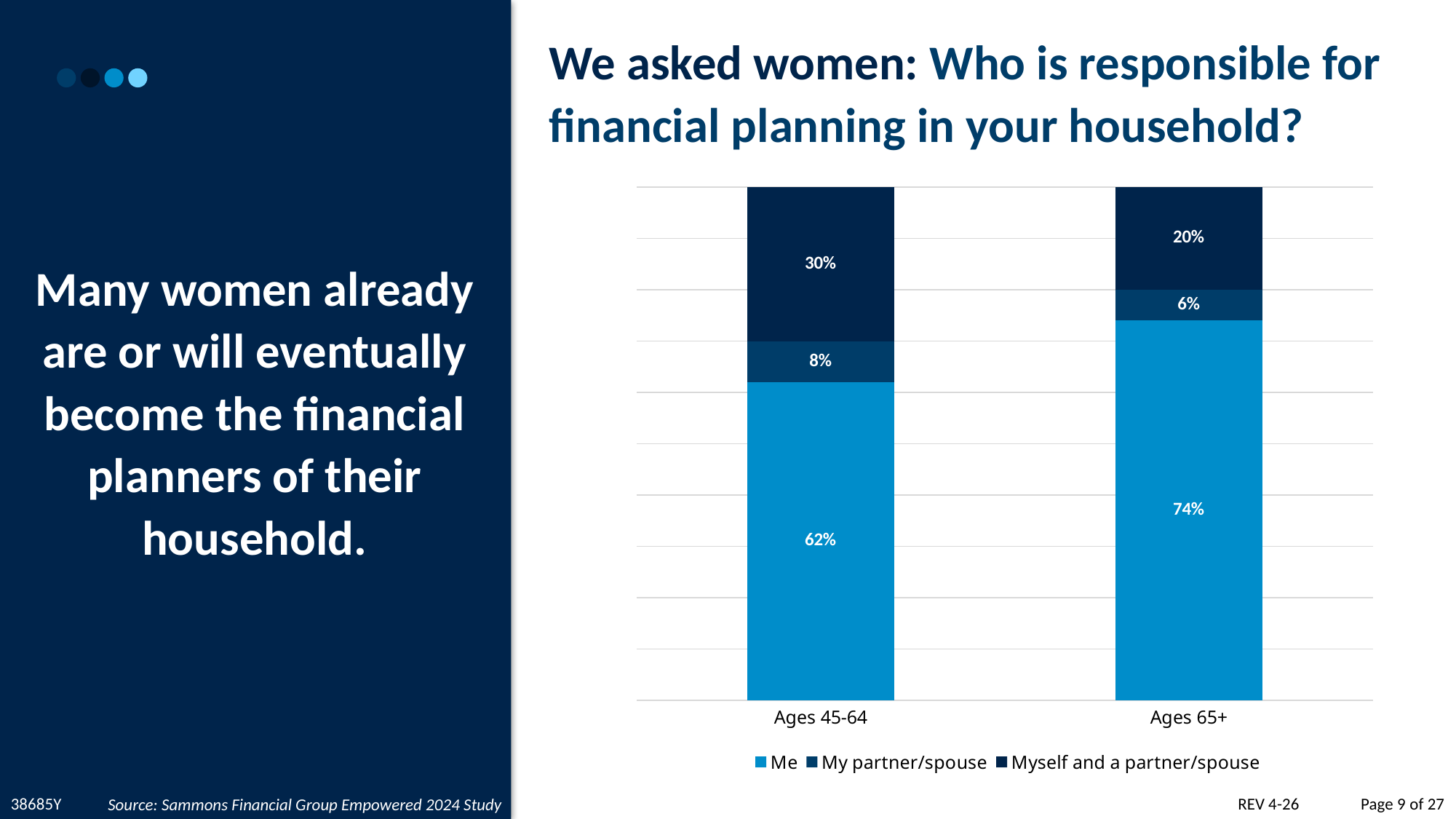
What is the total of the stacked bar for Ages 45-64? 100% What is the difference between the "Me" shares for Ages 65+ and Ages 45-64? 12% What percentage of women aged 45-64 said "My partner/spouse" is responsible? 8% Which age group has the higher share answering "Me"? Ages 65+ How many series does the legend list? 3 What percentage of women aged 65+ said "My partner/spouse" is responsible? 6% What percentage of women aged 65+ said "Myself and a partner/spouse" is responsible? 20% What kind of chart is shown on the slide? Stacked bar chart How many age groups are shown on the x axis? 2 What percentage of women aged 45-64 said "Me" is responsible for financial planning? 62% What is the difference between the "Myself and a partner/spouse" shares for Ages 45-64 and Ages 65+? 10% What percentage of women aged 65+ said "Me" is responsible for financial planning? 74%